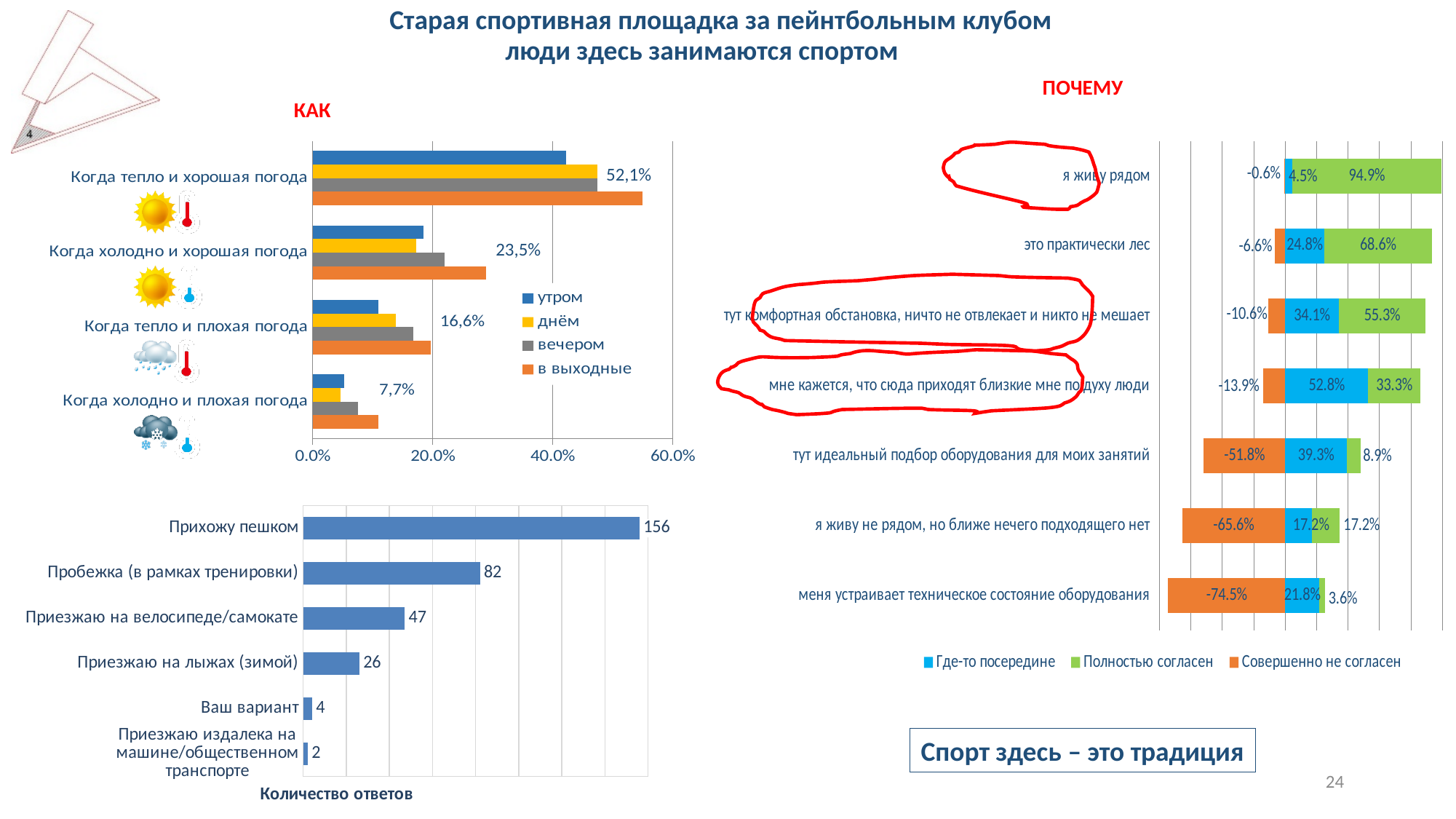
How many categories are shown in the bottom-left chart (Количество ответов)? 6 In the bottom-left chart (Количество ответов), which category has the lowest value? Приезжаю издалека на машине/общественном транспорте In the right chart (under 'ПОЧЕМУ'), what is the 'Совершенно не согласен' value for 'меня устраивает техническое состояние оборудования'? -74.5% In the right chart (under 'ПОЧЕМУ'), which has the larger 'Полностью согласен' value: 'это практически лес' or 'тут комфортная обстановка, ничто не отвлекает и никто не мешает'? это практически лес How many series does the legend of the top-left chart (under 'КАК') list? 4 In the bottom-left chart (Количество ответов), which category has the highest value? Прихожу пешком In the bottom-left chart (Количество ответов), what is the difference between 'Прихожу пешком' and 'Пробежка (в рамках тренировки)'? 74 In the bottom-left chart (Количество ответов), what is the value for 'Прихожу пешком'? 156 How many series does the legend of the right chart (under 'ПОЧЕМУ') list? 3 What kind of chart is the bottom-left chart (Количество ответов)? bar chart In the right chart (under 'ПОЧЕМУ'), what is the 'Полностью согласен' value for 'я живу рядом'? 94.9% In the top-left chart (under 'КАК'), is the value of 'в выходные' for 'Когда тепло и хорошая погода' greater or less than 40.0%? greater